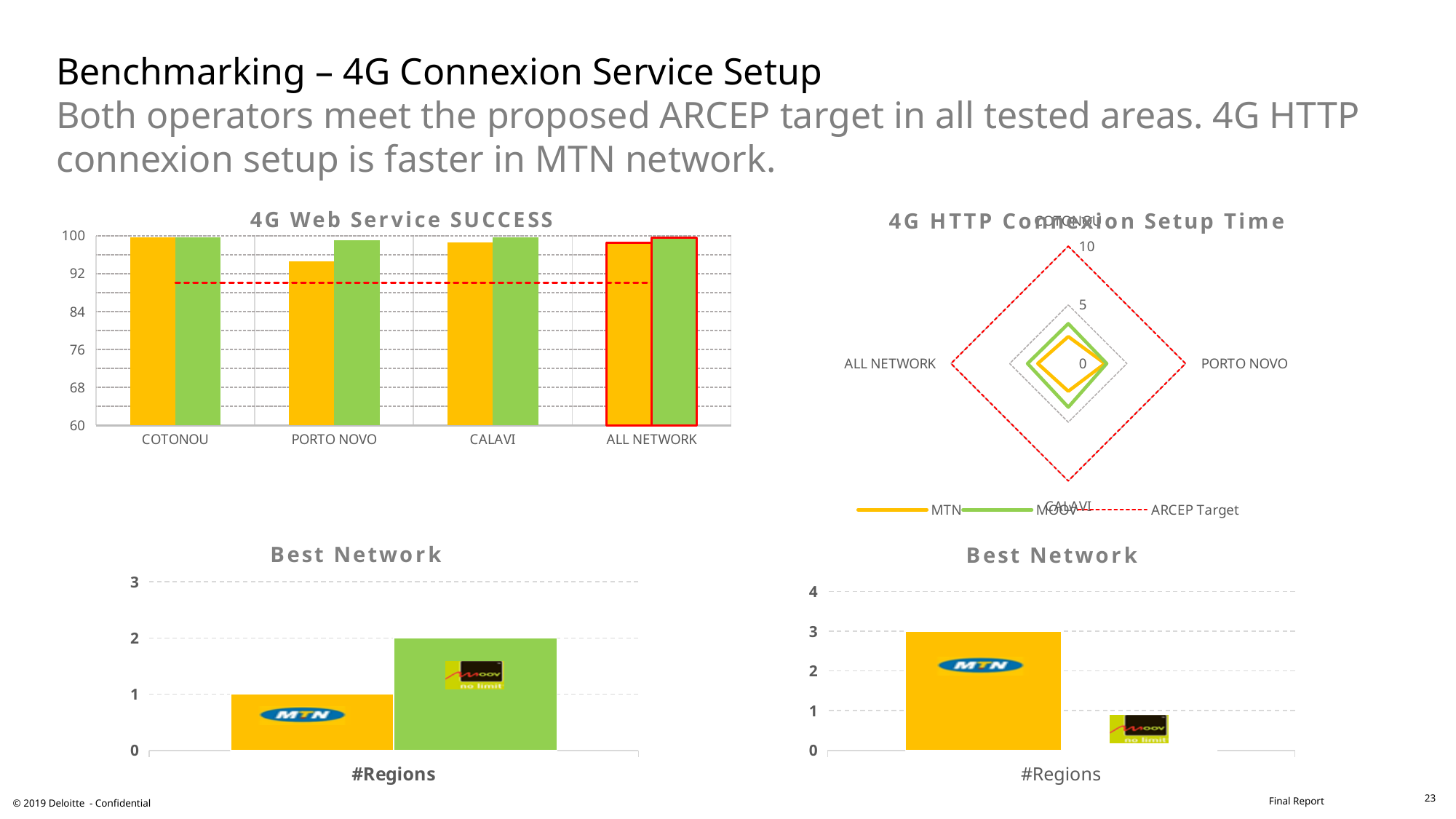
How many categories are shown on the x axis of the '4G Web Service SUCCESS' chart? 4 In the bottom-right 'Best Network' chart, is the Moov bar greater or less than 1? less In the '4G Web Service SUCCESS' chart, is the orange bar for PORTO NOVO greater or less than 92? greater In the bottom-left 'Best Network' chart, what is the value of the Moov bar? 2 In the bottom-right 'Best Network' chart, what is the value of the MTN bar? 3 In the '4G HTTP Connexion Setup Time' chart, is the MTN value for PORTO NOVO greater or less than 5? less In the bottom-left 'Best Network' chart, what is the value of the MTN bar? 1 What kind of chart is the '4G HTTP Connexion Setup Time' chart? radar chart In the bottom-left 'Best Network' chart, which operator has the higher bar? Moov How many series does the legend of the '4G HTTP Connexion Setup Time' chart list? 3 What kind of chart is the '4G Web Service SUCCESS' chart? bar chart